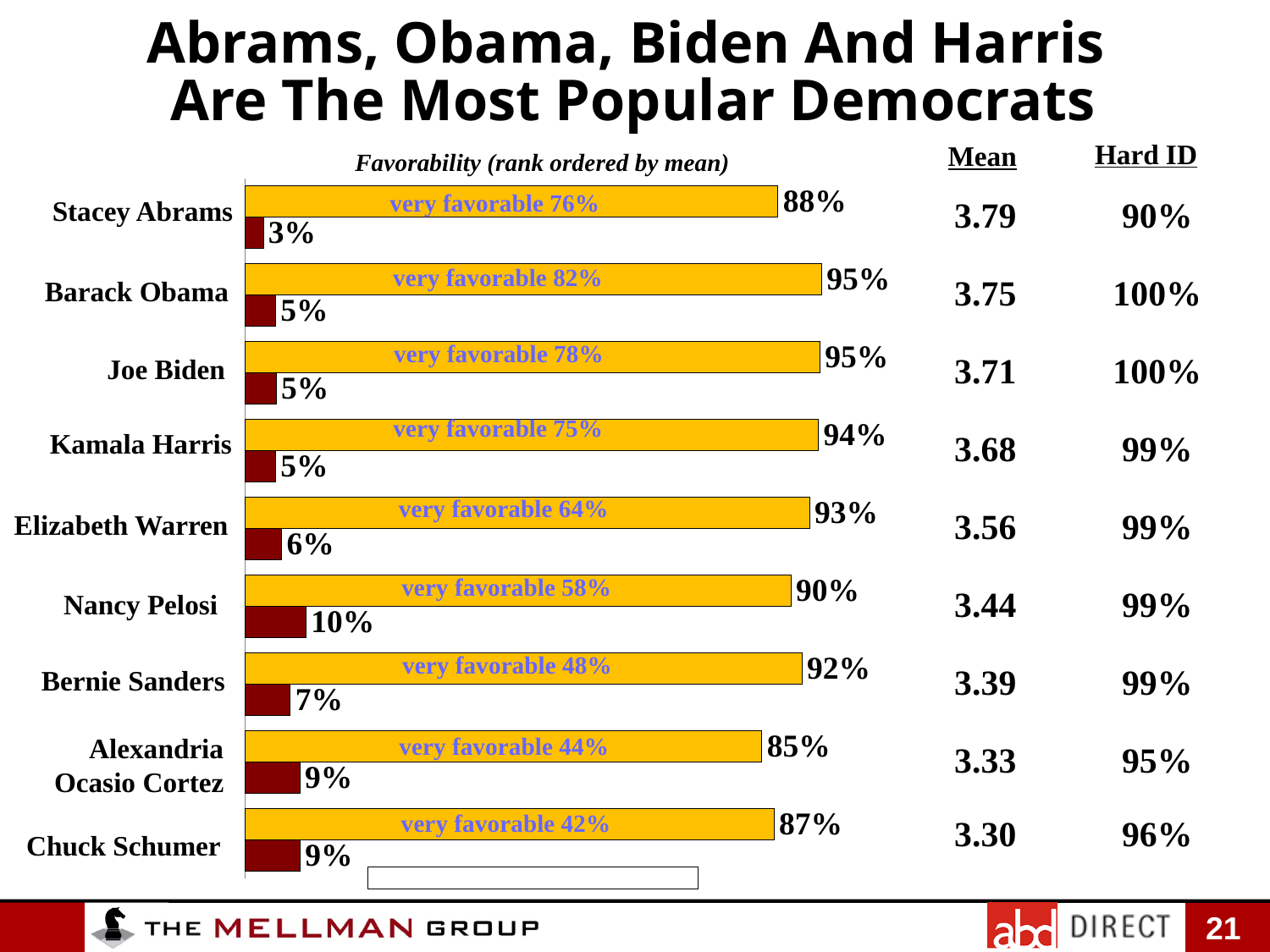
Which person has the highest unfavorable (red bar) percentage? Nancy Pelosi What kind of chart is shown on the slide? Bar chart What is the favorable percentage for Barack Obama? 95% What is the subtitle printed above the chart? Favorability (rank ordered by mean) Which person has the lowest favorable percentage? Alexandria Ocasio Cortez Which person has the lowest unfavorable (red bar) percentage? Stacey Abrams What is the unfavorable (red bar) percentage for Nancy Pelosi? 10% What is the 'very favorable' percentage shown for Bernie Sanders? 48% Who has a higher favorable percentage, Elizabeth Warren or Bernie Sanders? Elizabeth Warren What is the difference between Joe Biden's favorable percentage and Chuck Schumer's favorable percentage? 8% What is the difference between Barack Obama's 'very favorable' percentage and Chuck Schumer's 'very favorable' percentage? 40% How many people are shown in the chart? 9